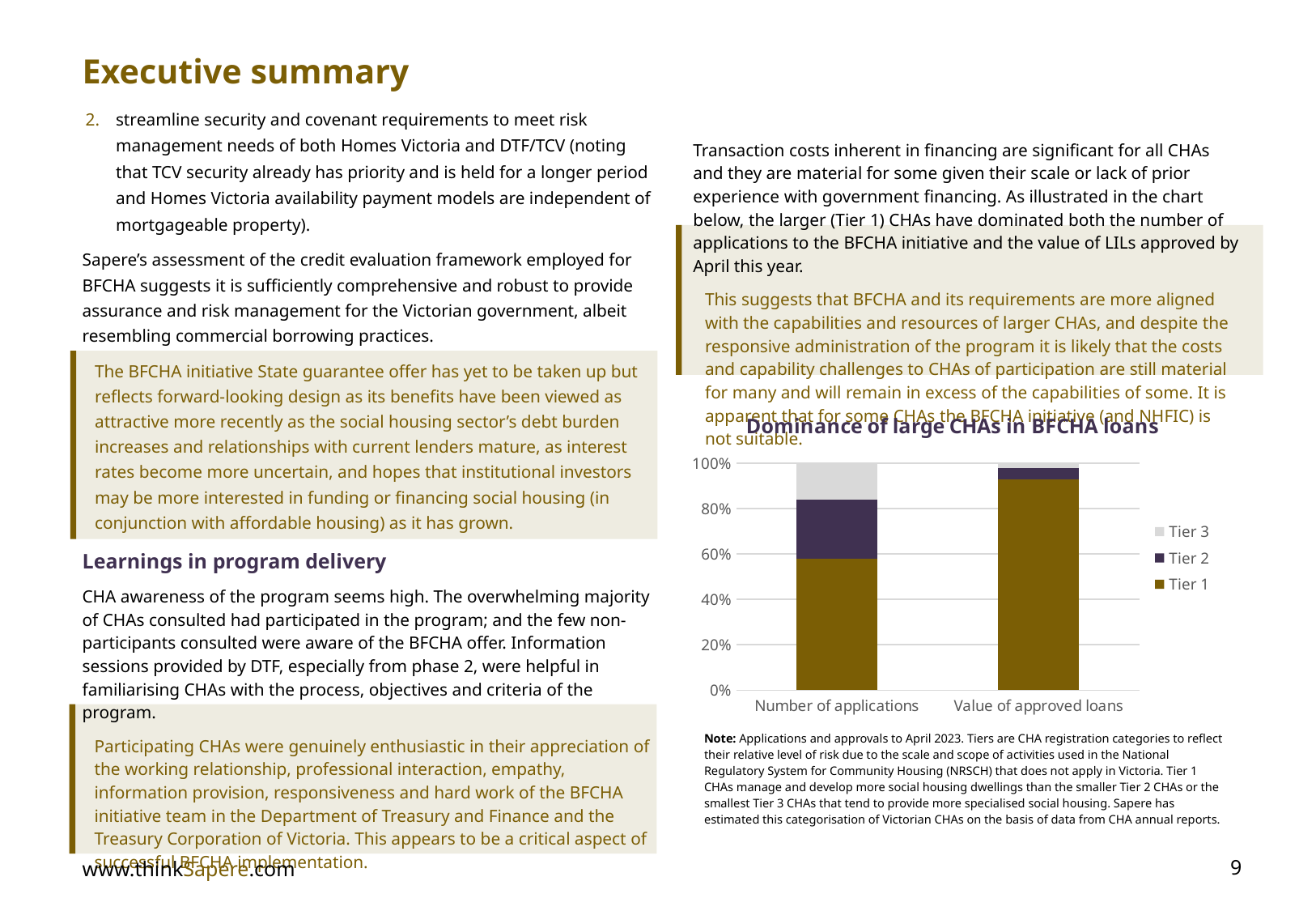
How many categories are shown on the x axis of the chart? 2 How many series does the chart legend list? 3 Is the Tier 1 share of Value of approved loans greater or less than 80%? greater Which series are listed in the chart legend? Tier 3, Tier 2, Tier 1 Is the Tier 1 share of Number of applications greater or less than 40%? greater What is the total of the stacked bar for Number of applications? 100% Is the Tier 2 share of Value of approved loans greater or less than 20%? less What kind of chart is shown on the slide? Stacked bar chart What is the title of the chart? Dominance of large CHAs in BFCHA loans Which tier has the largest share of Number of applications? Tier 1 In which category is the Tier 1 share larger, Number of applications or Value of approved loans? Value of approved loans Which tier has the smallest share of Number of applications? Tier 3